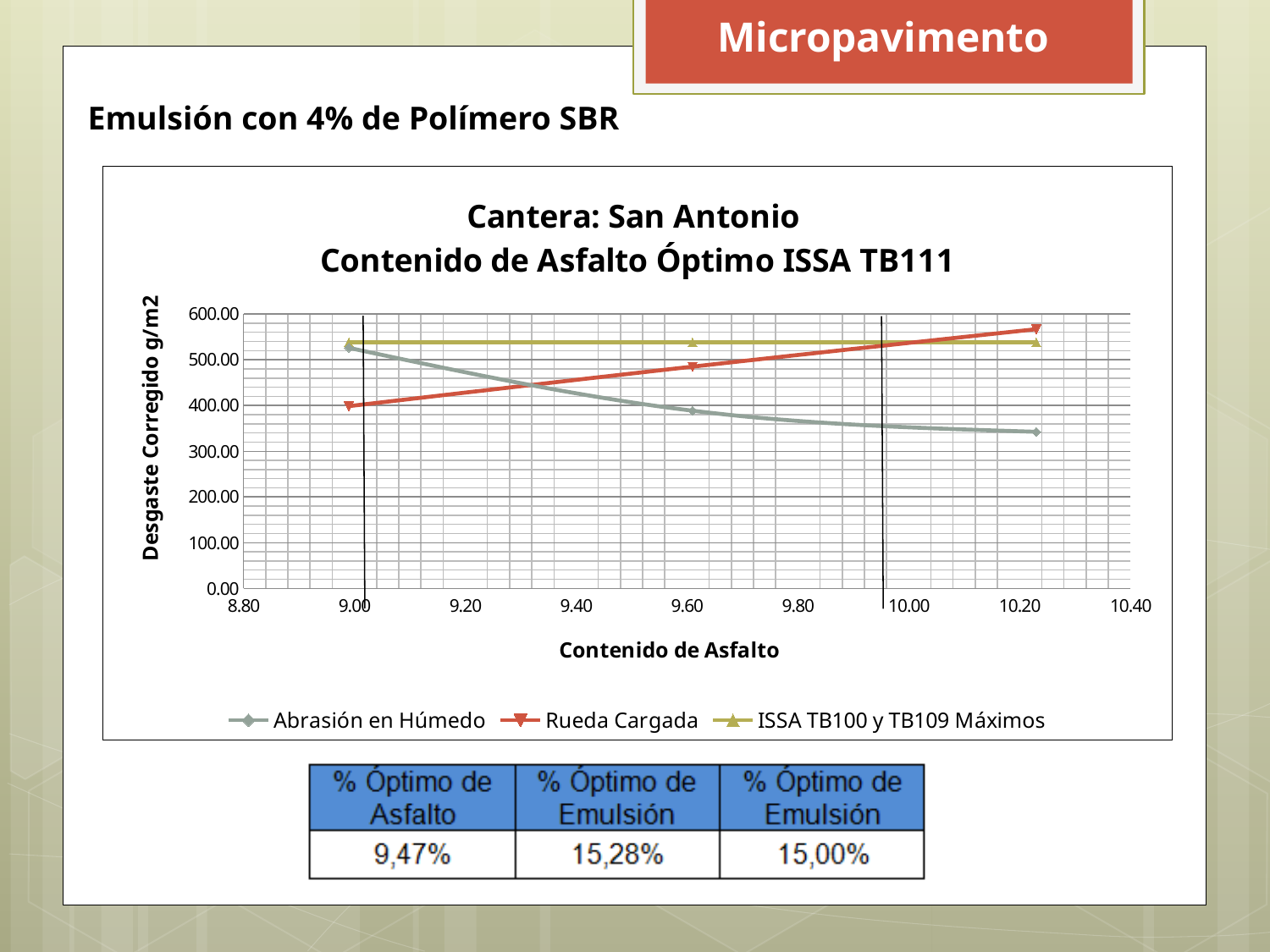
Is the first (leftmost) value of the Abrasión en Húmedo series greater or less than 500.00? greater What kind of chart is shown on the slide? Line chart At the rightmost data point (near 10.20), which series has the highest value? Rueda Cargada Is the first (leftmost) value of the Rueda Cargada series greater or less than 500.00? less How many series does the chart legend list? 3 What is the label of the vertical axis of the chart? Desgaste Corregido g/m2 How many data points are plotted for the Abrasión en Húmedo series? 3 Is the last (rightmost) value of the Abrasión en Húmedo series greater or less than 400.00? less At the leftmost data point (near 9.00), which series is higher: Abrasión en Húmedo or Rueda Cargada? Abrasión en Húmedo Does the Rueda Cargada series rise or fall as Contenido de Asfalto increases? Rise Does the Abrasión en Húmedo series rise or fall as Contenido de Asfalto increases? Fall What is the title of the chart? Cantera: San Antonio Contenido de Asfalto Óptimo ISSA TB111